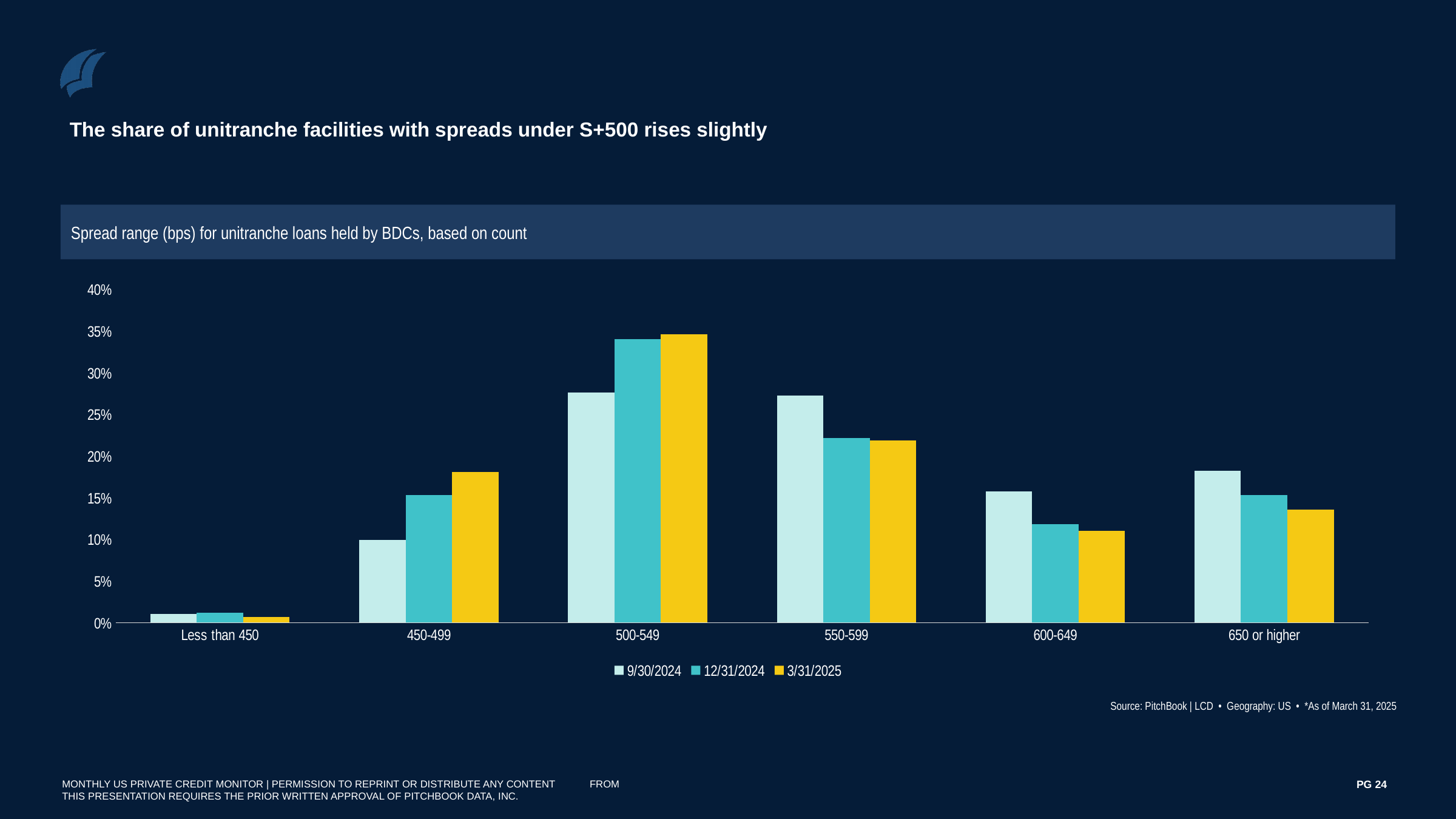
For the 550-599 range, which is larger: the 9/30/2024 value or the 3/31/2025 value? 9/30/2024 For the 600-649 range, do the values rise or fall from 9/30/2024 to 3/31/2025? fall Which spread range has the highest share for 3/31/2025? 500-549 How many spread range categories are shown on the x axis? 6 For the 450-499 range, which is larger: the 9/30/2024 value or the 3/31/2025 value? 3/31/2025 Is the value for 450-499 on 9/30/2024 greater or less than 15%? less Which spread range has the lowest share for 9/30/2024? Less than 450 Is the value for 650 or higher on 3/31/2025 greater or less than 10%? greater What kind of chart is shown on the slide? bar chart Is the value for 500-549 on 12/31/2024 greater or less than 30%? greater Which series is shown in yellow in the legend? 3/31/2025 How many series does the legend list? 3